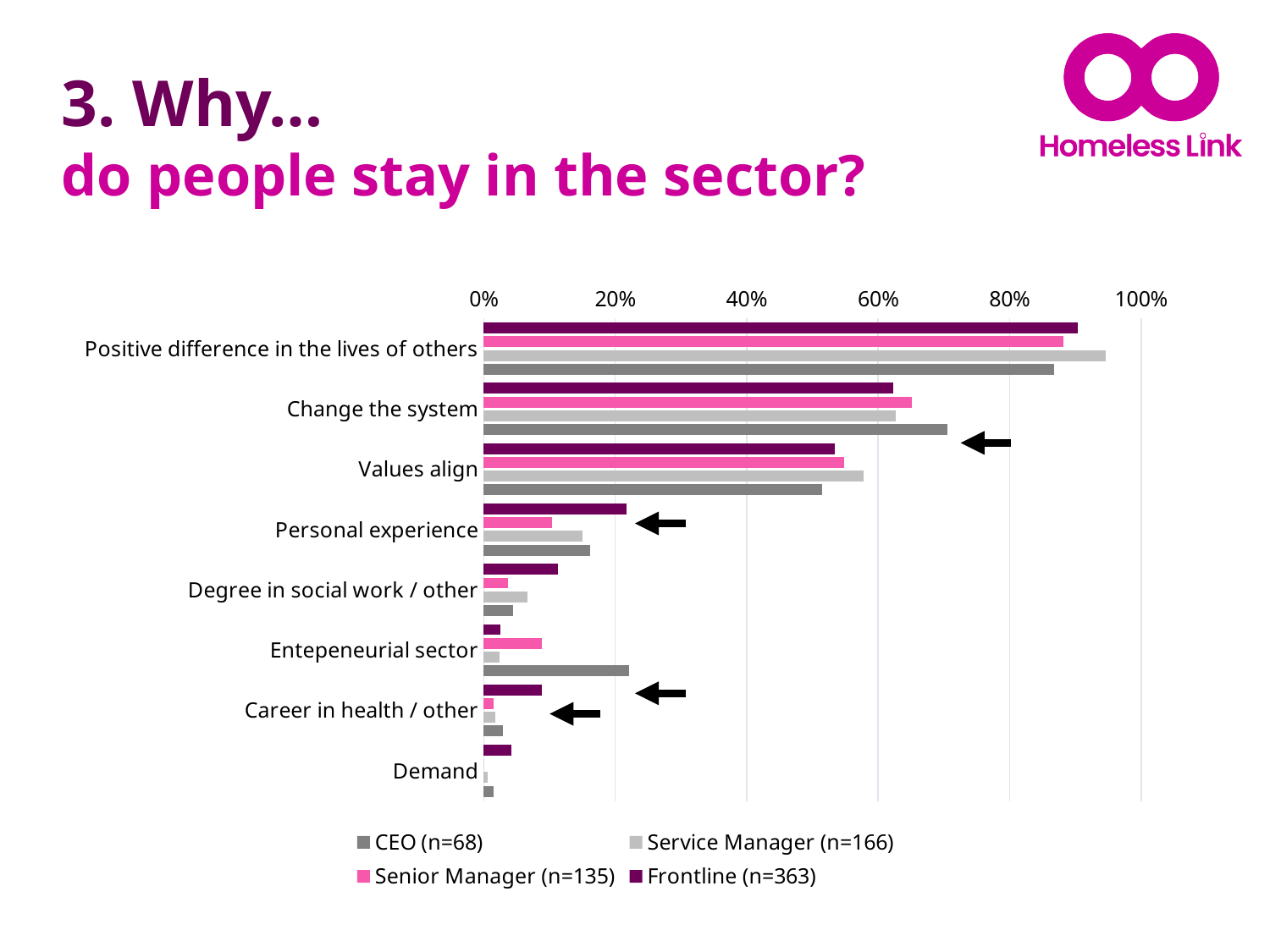
According to the legend, what is the sample size (n) for the Frontline series? 363 For 'Change the system', which series has the highest value? CEO (n=68) How many series does the legend list? 4 Is the Senior Manager value for 'Values align' greater or less than 60%? less How many categories (reasons) are listed on the chart? 8 For 'Personal experience', is the value for Frontline or Senior Manager larger? Frontline For 'Entepeneurial sector', which series has the highest value? CEO (n=68) Is the Service Manager value for 'Positive difference in the lives of others' greater or less than 80%? greater Is the CEO value for 'Change the system' greater or less than 60%? greater Which category has the highest value for the Frontline series? Positive difference in the lives of others What kind of chart is shown on the slide? Bar chart